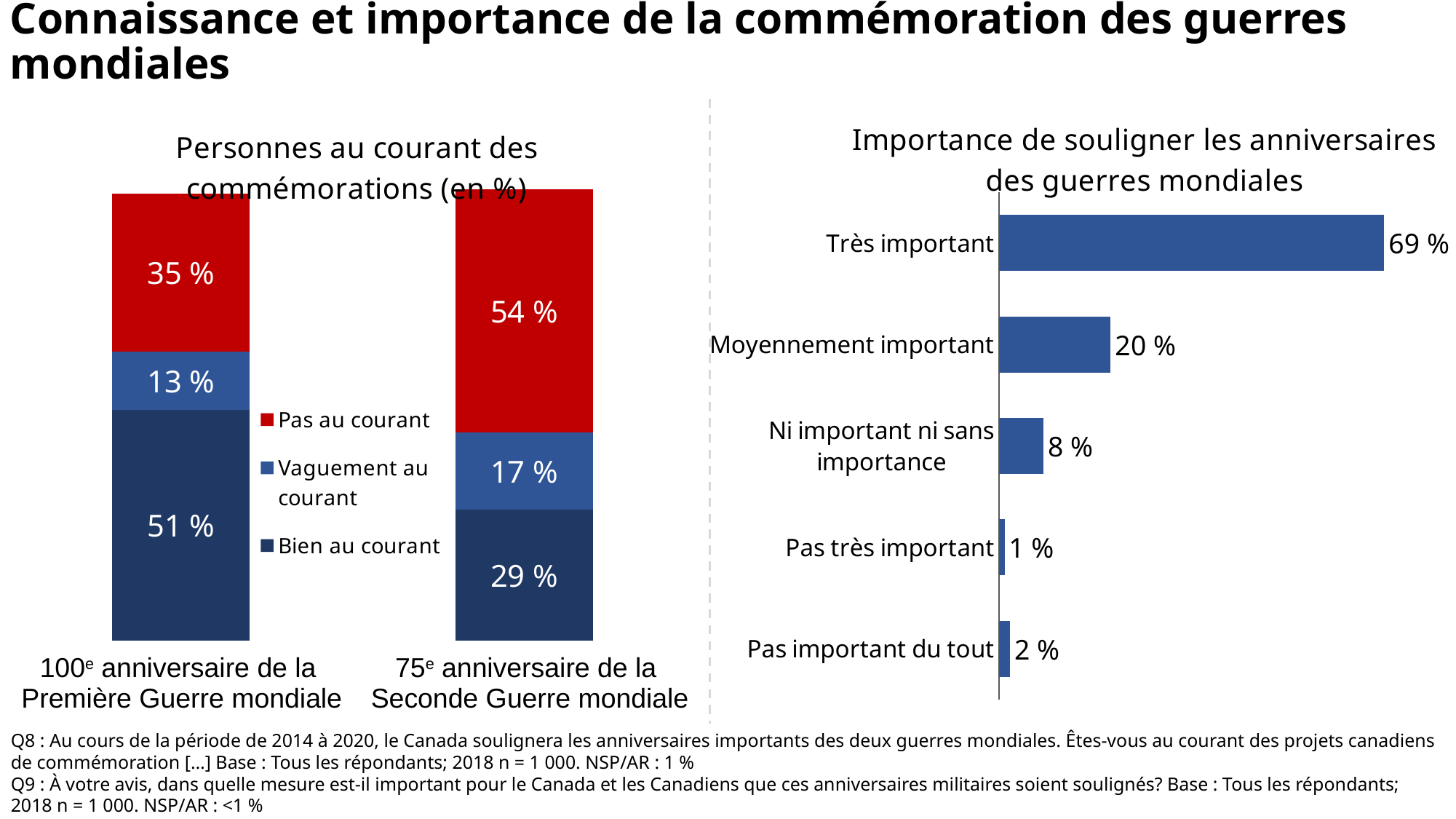
In the chart 'Importance de souligner les anniversaires des guerres mondiales', which category has the lowest value? Pas très important In the chart 'Personnes au courant des commémorations (en %)', what is the value for 'Pas au courant' for the 75e anniversaire de la Seconde Guerre mondiale? 54 % How many categories are shown in the chart 'Importance de souligner les anniversaires des guerres mondiales'? 5 In the chart 'Importance de souligner les anniversaires des guerres mondiales', which category has the highest value? Très important In the chart 'Importance de souligner les anniversaires des guerres mondiales', what is the value for 'Moyennement important'? 20 % In the chart 'Personnes au courant des commémorations (en %)', what is the difference between the 'Vaguement au courant' values for the 75e anniversaire de la Seconde Guerre mondiale and the 100e anniversaire de la Première Guerre mondiale? 4 % In the chart 'Importance de souligner les anniversaires des guerres mondiales', what is the difference between 'Très important' and 'Moyennement important'? 49 % In the chart 'Personnes au courant des commémorations (en %)', what is the total of the stacked bar for the 75e anniversaire de la Seconde Guerre mondiale? 100 % How many series does the legend of the chart 'Personnes au courant des commémorations (en %)' list? 3 In the chart 'Personnes au courant des commémorations (en %)', which category has the larger 'Bien au courant' value? 100e anniversaire de la Première Guerre mondiale What kind of chart is 'Personnes au courant des commémorations (en %)'? Stacked bar chart In the chart 'Personnes au courant des commémorations (en %)', what is the value for 'Bien au courant' for the 100e anniversaire de la Première Guerre mondiale? 51 %